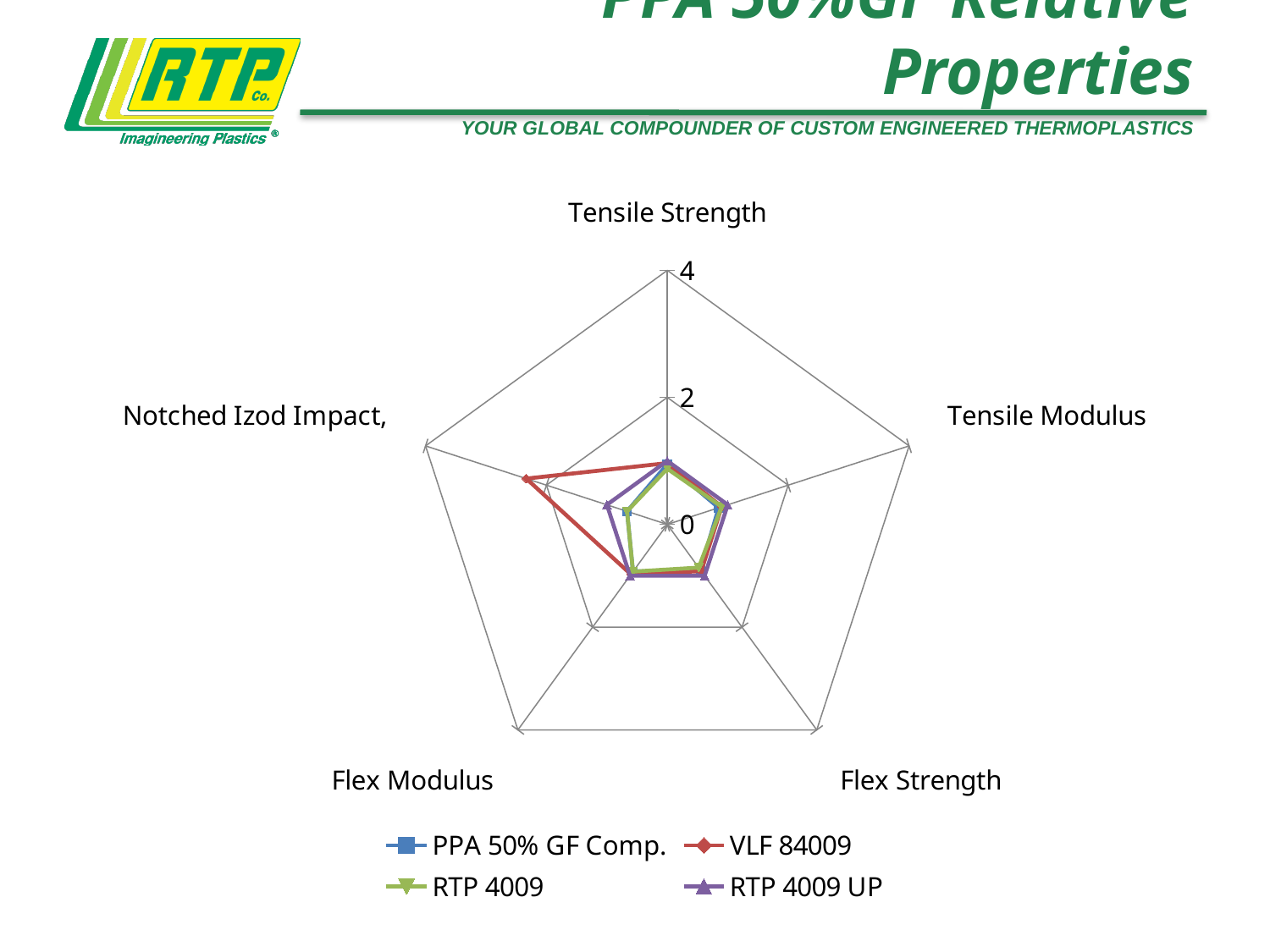
Is the Tensile Strength value for PPA 50% GF Comp. greater or less than 2? less Which series are listed in the chart legend? PPA 50% GF Comp., VLF 84009, RTP 4009, RTP 4009 UP What is the maximum value shown on the radar chart's axis scale? 4 How many series does the chart legend list? 4 What kind of chart is shown on the slide? Radar chart Is the Notched Izod Impact value for VLF 84009 greater or less than 2? greater On the Notched Izod Impact axis, which is larger: VLF 84009 or RTP 4009? VLF 84009 Which series has the highest value on the Notched Izod Impact axis? VLF 84009 Is the Tensile Modulus value for RTP 4009 UP greater or less than 2? less What is the title of the chart on the slide? PPA 50%GF Relative Properties How many property axes does the radar chart have? 5 On which property axis does VLF 84009 reach its highest value? Notched Izod Impact